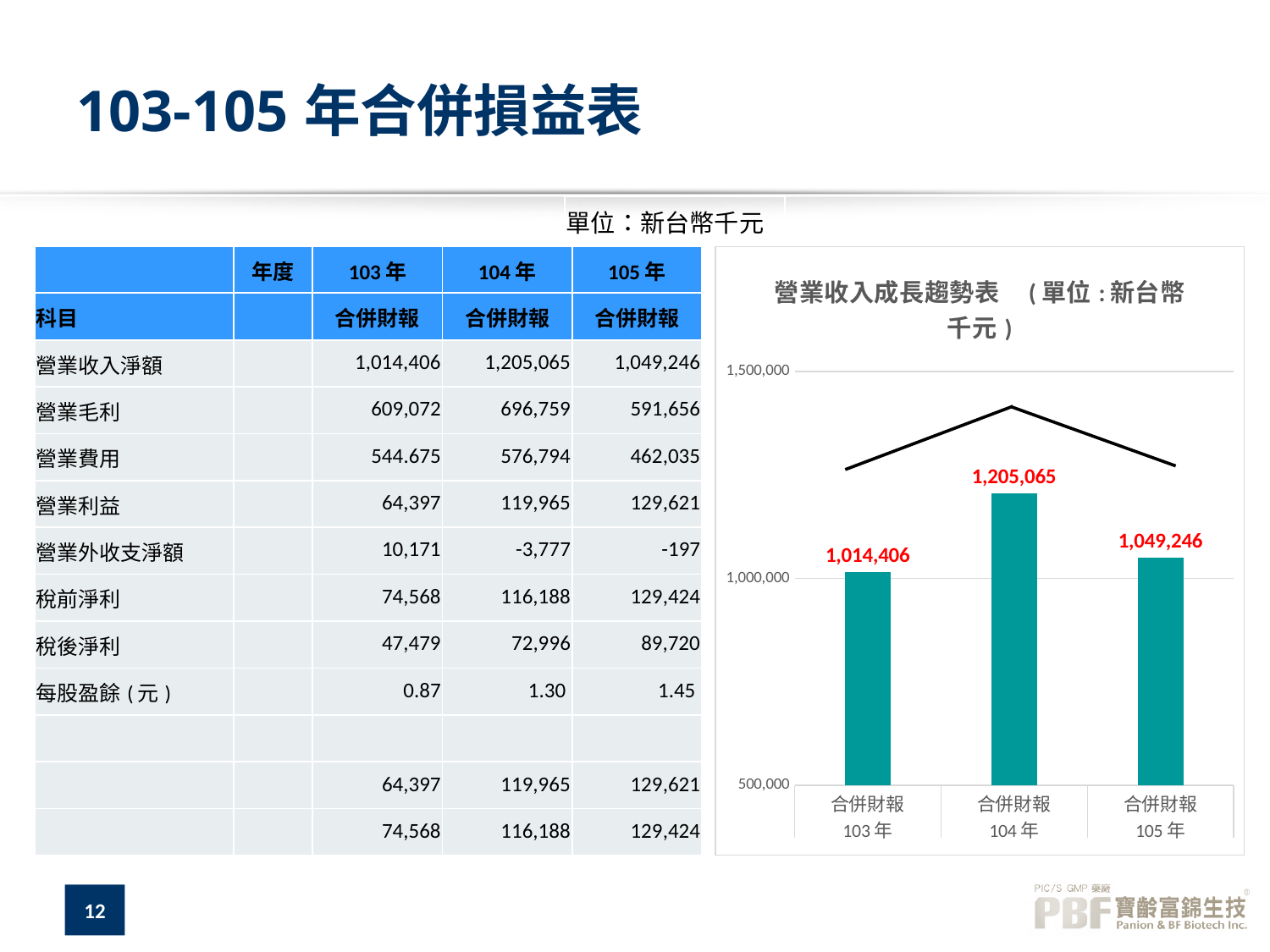
What is the value for 104 年 in the chart? 1,205,065 Which year has the highest value in the chart? 104 年 What is the value for 103 年 in the chart? 1,014,406 Is the value for 104 年 in the chart greater or less than 1,500,000? less How many bars are plotted in the chart? 3 Which year has the lowest value in the chart? 103 年 What is the difference between the values for 104 年 and 105 年 in the chart? 155,819 Which is larger in the chart, the value for 105 年 or the value for 103 年? 105 年 What is the difference between the values for 104 年 and 103 年 in the chart? 190,659 What kind of chart is shown on the slide? bar chart What is the title of the chart on the slide? 營業收入成長趨勢表 (單位：新台幣千元) What is the value for 105 年 in the chart? 1,049,246